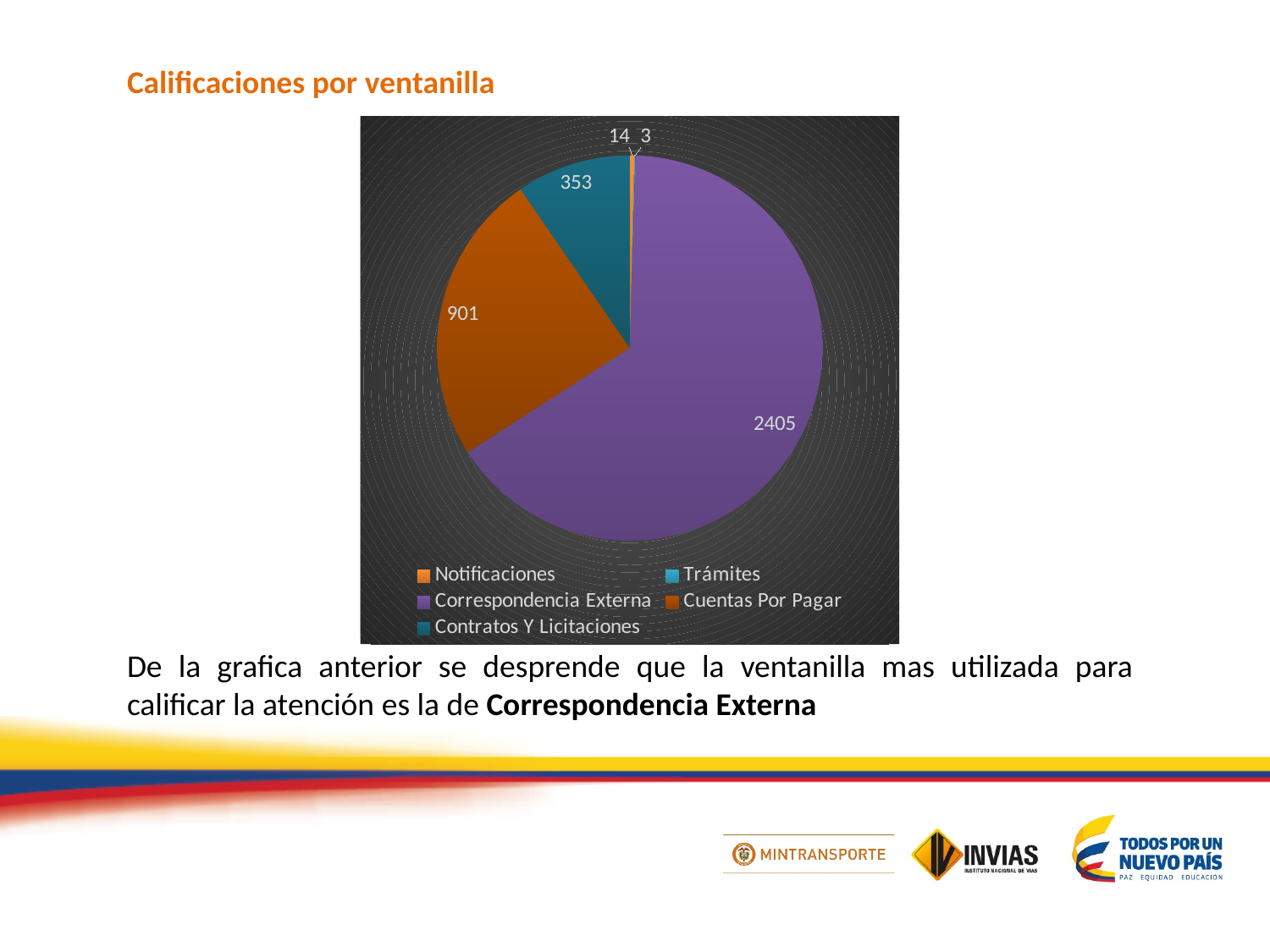
What is the value for Contratos Y Licitaciones? 353 Which is larger, the value for Cuentas Por Pagar or the value for Contratos Y Licitaciones? Cuentas Por Pagar What is the value for Trámites? 3 What is the difference between the values for Correspondencia Externa and Cuentas Por Pagar? 1504 What type of chart is shown on the slide? pie chart What is the value for Correspondencia Externa? 2405 What is the value for Notificaciones? 14 What is the title of the chart? Calificaciones por ventanilla What is the value for Cuentas Por Pagar? 901 How many categories does the legend list? 5 Which category has the largest slice of the pie? Correspondencia Externa Which category has the smallest slice of the pie? Trámites